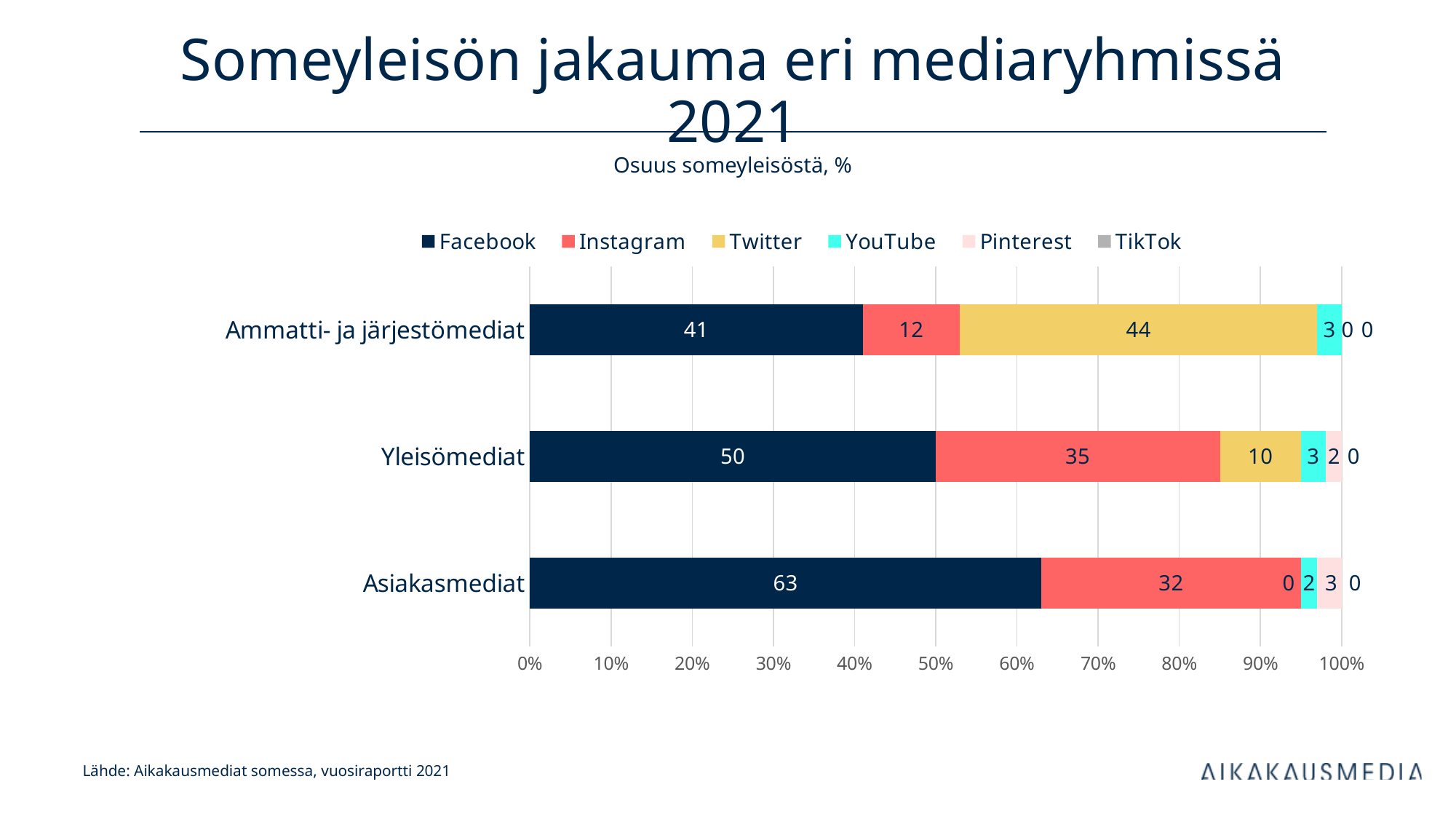
What kind of chart is shown on the slide? Stacked bar chart How many series does the legend list? 6 What is the Facebook value for Asiakasmediat? 63 What is the difference between the Facebook values for Asiakasmediat and Yleisömediat? 13 What is the total of the stacked bar for Yleisömediat? 100 What is the Pinterest value for Asiakasmediat? 3 Which is larger: the Twitter value for Ammatti- ja järjestömediat or the Twitter value for Yleisömediat? Ammatti- ja järjestömediat Which category has the highest Facebook value? Asiakasmediat What is the Twitter value for Ammatti- ja järjestömediat? 44 Which category has the lowest Instagram value? Ammatti- ja järjestömediat What is the Instagram value for Yleisömediat? 35 How many categories are shown on the chart? 3